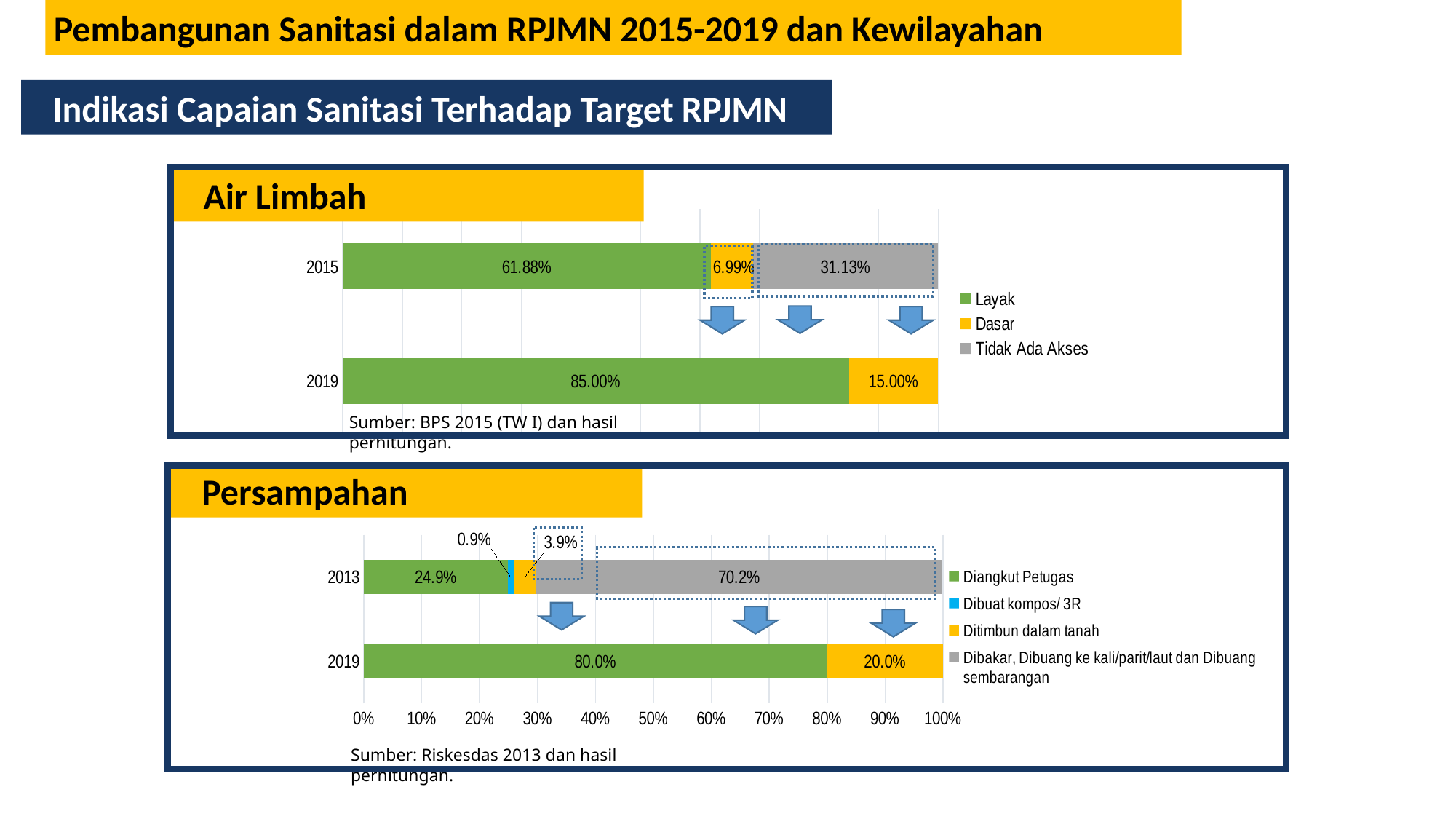
In the Air Limbah chart, which segment is larger in 2015: Dasar or Tidak Ada Akses? Tidak Ada Akses In the Persampahan chart, what is the value for Diangkut Petugas in 2013? 24.9% In the Persampahan chart, how many series does the legend list? 4 In the Air Limbah chart, how many series does the legend list? 3 In the Air Limbah chart, what is the value for Layak in 2015? 61.88% In the Persampahan chart, which category has the largest share in 2013? Dibakar, Dibuang ke kali/parit/laut dan Dibuang sembarangan In the Persampahan chart, what is the value for Dibuat kompos/ 3R in 2013? 0.9% In the Persampahan chart, what is the difference between the Diangkut Petugas value in 2019 and in 2013? 55.1% What type of chart is the Persampahan chart? Stacked bar chart In the Air Limbah chart, what is the value for Dasar in 2019? 15.00% In the Air Limbah chart, what is the difference between the Layak value in 2019 and the Layak value in 2015? 23.12% In the Air Limbah chart, what is the value for Tidak Ada Akses in 2015? 31.13%